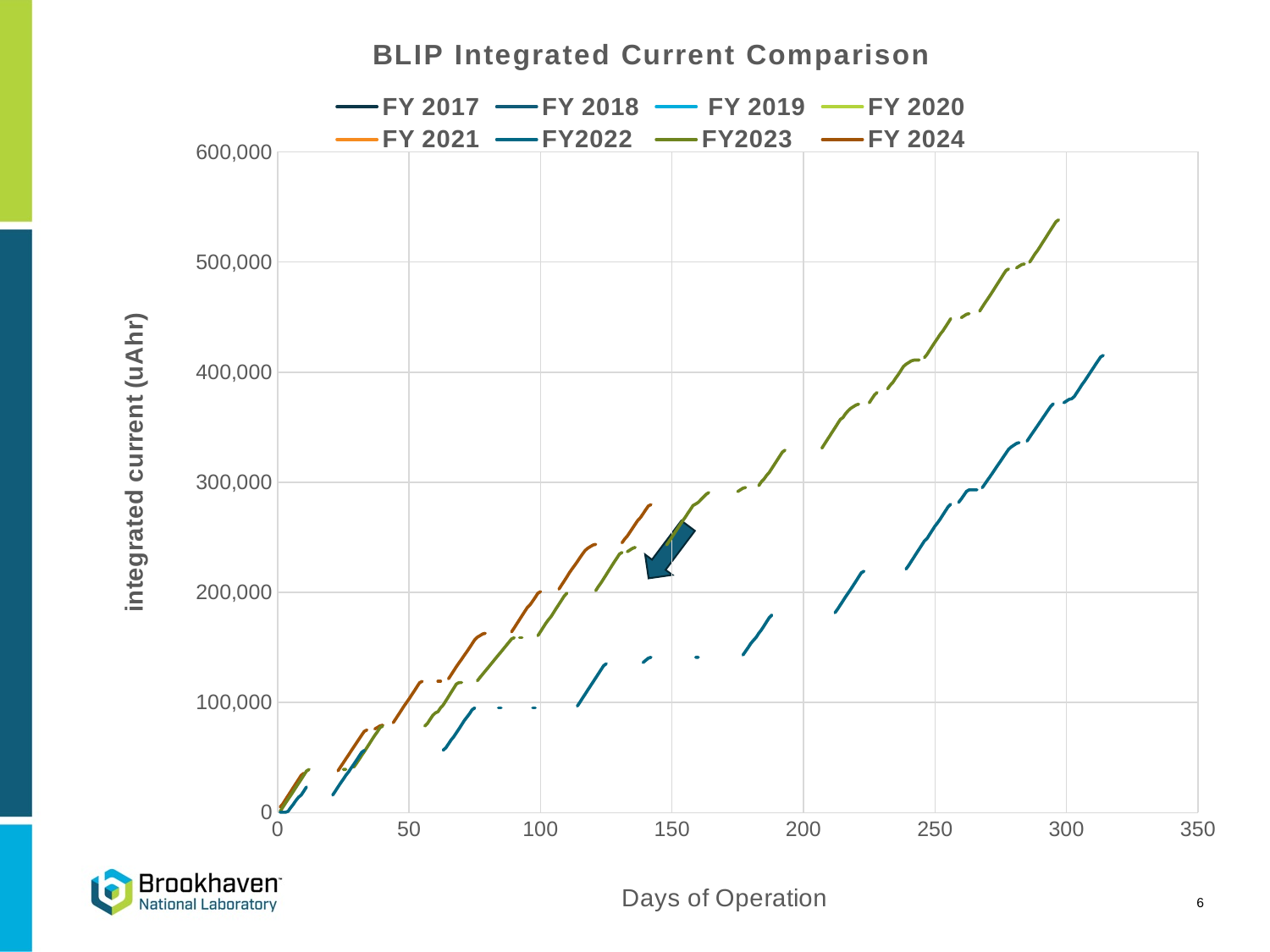
What is the label of the vertical axis? integrated current (uAhr) At 150 days of operation, which line is higher, FY2023 or FY2022? FY2023 Is the highest value reached by the FY2023 line greater or less than 500,000? greater Do the plotted lines rise or fall as days of operation increase? rise At 100 days of operation, which line is higher, FY 2024 or FY2023? FY 2024 What is the title of the chart? BLIP Integrated Current Comparison Is the highest value reached by the FY 2024 line greater or less than 300,000? less Which series reaches the highest integrated current on the chart? FY2023 Is the FY2023 value at 200 days of operation greater or less than 300,000? greater How many series does the legend list? 8 What kind of chart is shown on the slide? line chart